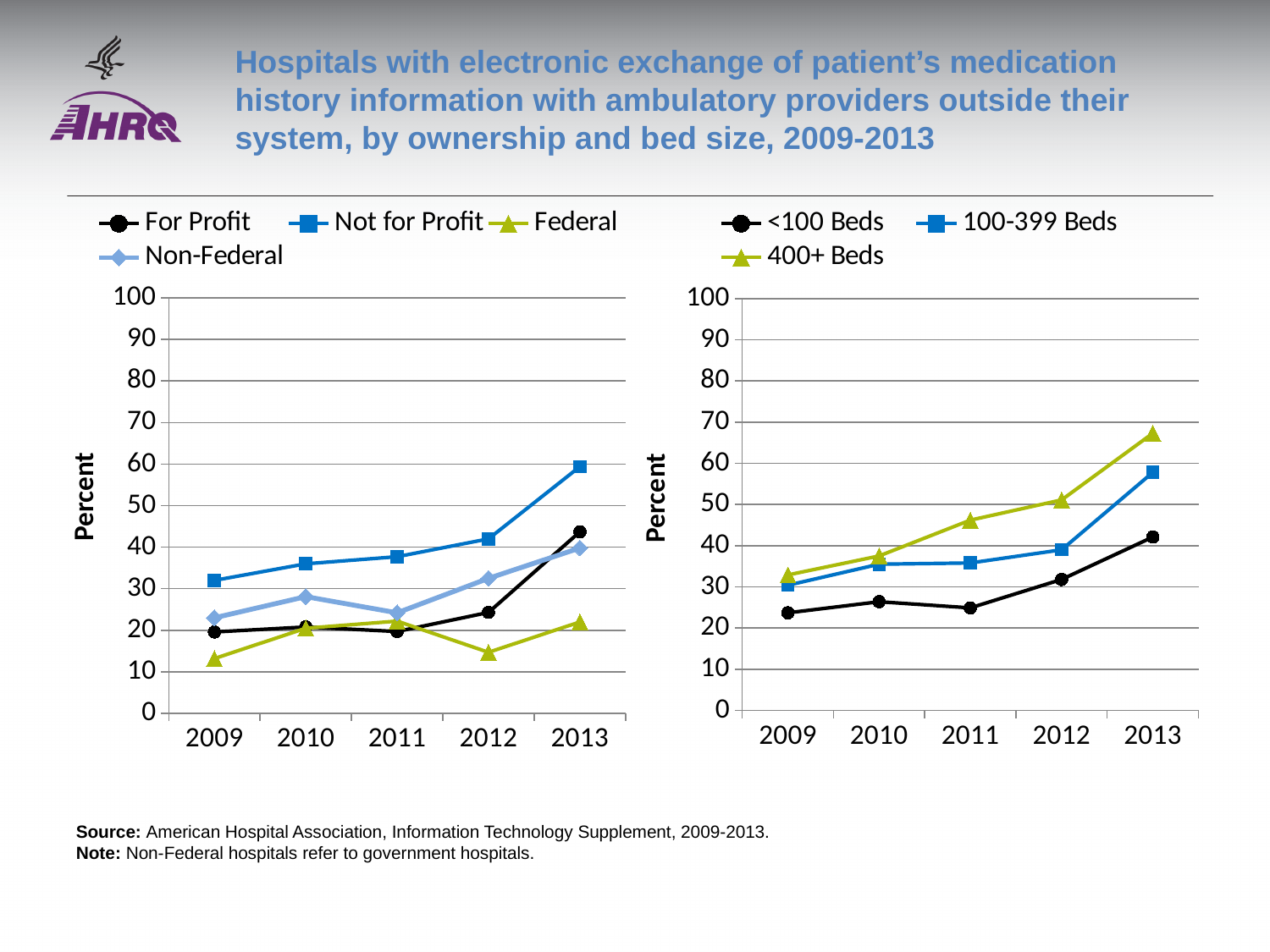
In the right chart (by bed size), does the 400+ Beds line rise or fall from 2009 to 2013? rises In the left chart (by ownership), which series has the lowest value in 2013? Federal How many series does the legend of the right chart (by bed size) list? 3 How many series does the legend of the left chart (by ownership) list? 4 In the left chart (by ownership), which series has the highest value in 2013? Not for Profit What kind of chart is the left chart (by ownership)? line chart In the right chart (by bed size), is the value for 400+ Beds in 2013 greater or less than 60? greater In the left chart (by ownership), is the value for Federal in 2009 greater or less than 20? less How many years are shown on the x axis of the right chart (by bed size)? 5 In the right chart (by bed size), which series has the highest value in 2013? 400+ Beds In the right chart (by bed size), which is larger in 2011: 400+ Beds or <100 Beds? 400+ Beds In the left chart (by ownership), is the value for Not for Profit in 2013 greater or less than 50? greater